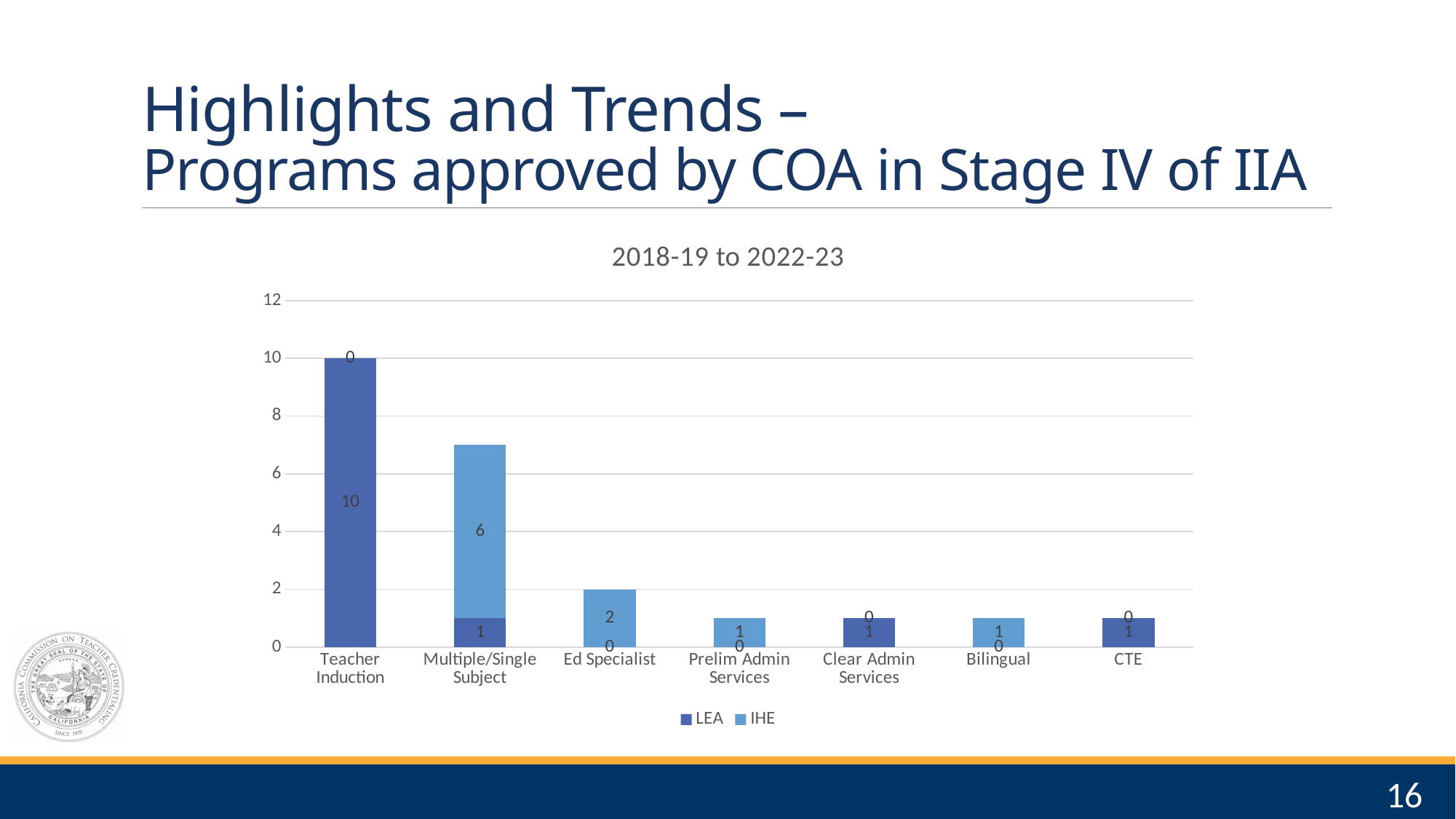
What kind of chart is shown on the slide? Stacked bar chart Which is larger, the IHE value for Ed Specialist or the IHE value for Bilingual? Ed Specialist Which category has the highest IHE value? Multiple/Single Subject What is the IHE value for Multiple/Single Subject? 6 How many categories are shown on the x axis? 7 What is the total of the stacked bar for Multiple/Single Subject? 7 What is the IHE value for Ed Specialist? 2 What is the LEA value for Teacher Induction? 10 What is the LEA value for Multiple/Single Subject? 1 Which category has the highest LEA value? Teacher Induction How many series does the legend list? 2 What is the difference between the LEA value for Teacher Induction and the IHE value for Multiple/Single Subject? 4